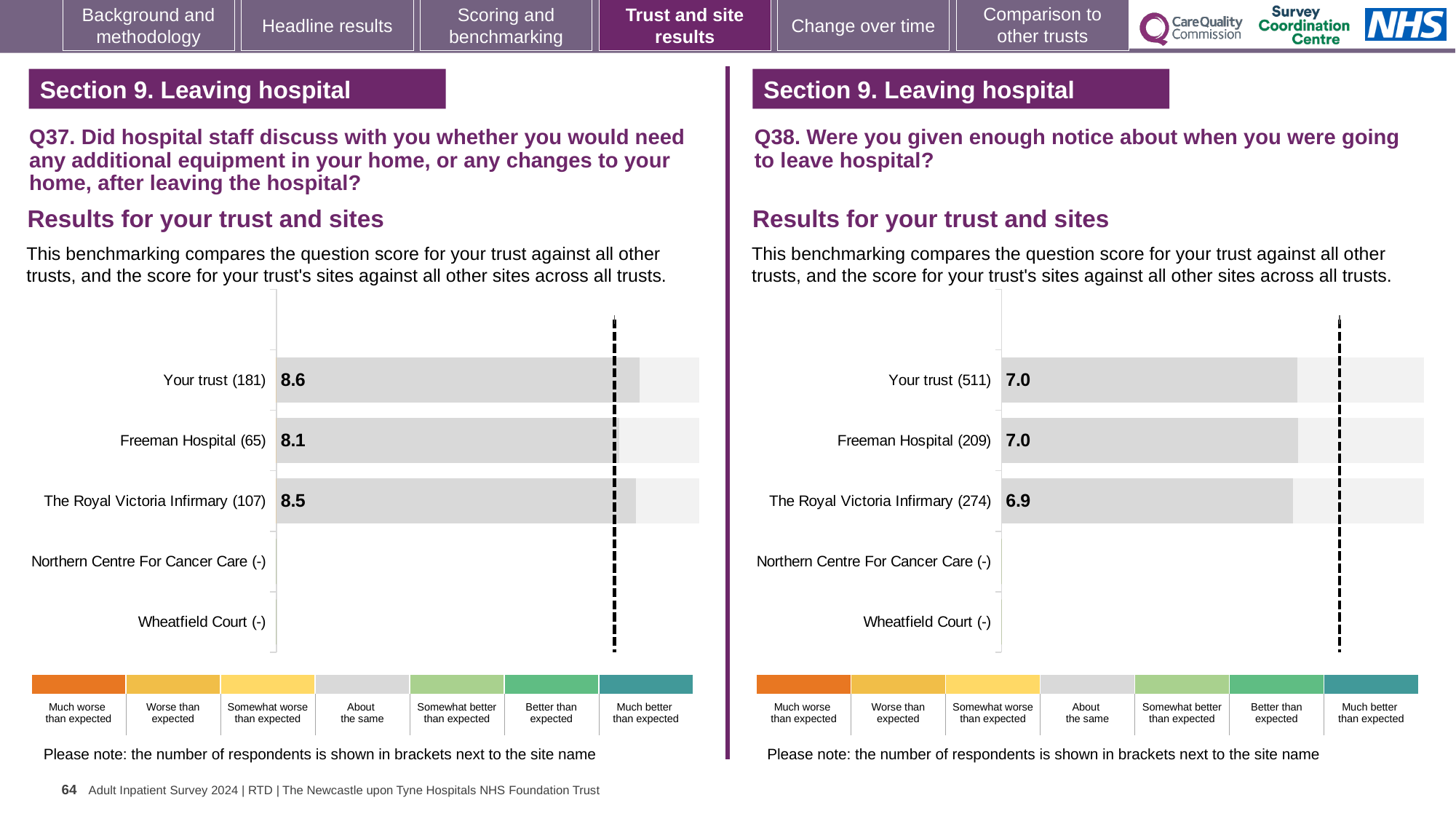
In the Q37 chart on the left, what is the score for Freeman Hospital? 8.1 In the Q37 chart on the left, which site or trust has the lowest score? Freeman Hospital In the Q37 chart on the left, which has the larger score, The Royal Victoria Infirmary or Freeman Hospital? The Royal Victoria Infirmary In the Q37 chart on the left, what is the difference between the scores for Your trust and Freeman Hospital? 0.5 In the Q37 chart on the left, which site or trust has the highest score? Your trust In the Q38 chart on the right, what is the difference between the scores for Freeman Hospital and The Royal Victoria Infirmary? 0.1 In the Q38 chart on the right, how many respondents are shown in brackets for Freeman Hospital? 209 What type of chart is used for the Q37 results on the left? Bar chart In the Q38 chart on the right, what is the score for Your trust? 7.0 In the Q38 chart on the right, how many sites or trusts have a score shown? 3 In the Q37 chart on the left, what is the score for Your trust? 8.6 In the Q38 chart on the right, what is the score for The Royal Victoria Infirmary? 6.9